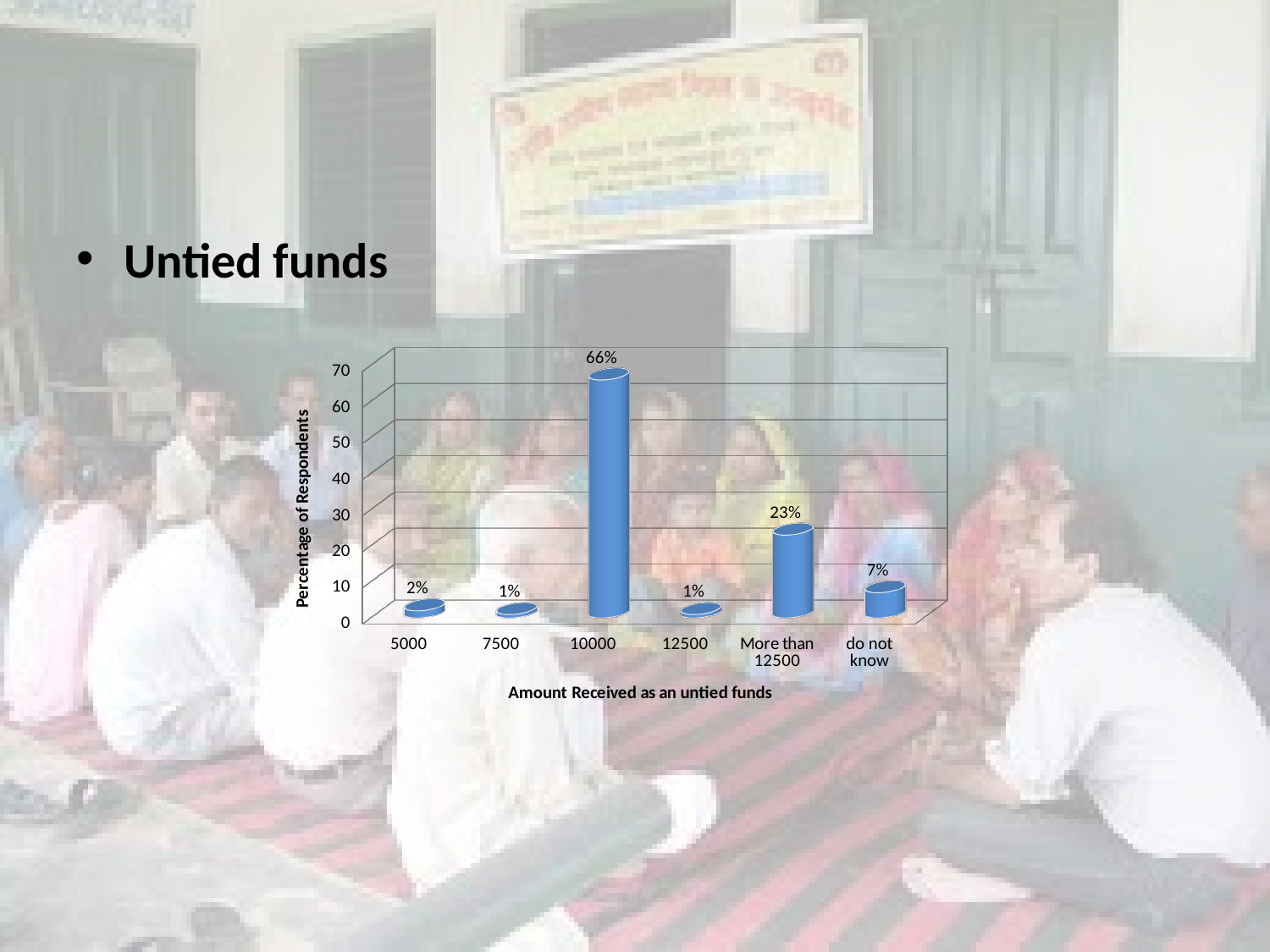
What kind of chart is shown on the slide? bar chart What is the difference in percentage points between the 10000 category and the 'More than 12500' category? 43 What percentage of respondents received more than 12500 as an untied fund? 23% What is the label of the x axis of the chart? Amount Received as an untied funds Which amount category has the highest percentage of respondents? 10000 Is the value for 'More than 12500' greater or less than 20? greater What percentage of respondents received 10000 as an untied fund? 66% What is the label of the y axis of the chart? Percentage of Respondents Which has a larger percentage of respondents: 'do not know' or 5000? do not know What percentage of respondents received 5000 as an untied fund? 2% How many amount categories are shown on the x axis of the chart? 6 What percentage of respondents answered 'do not know' about the amount received as an untied fund? 7%